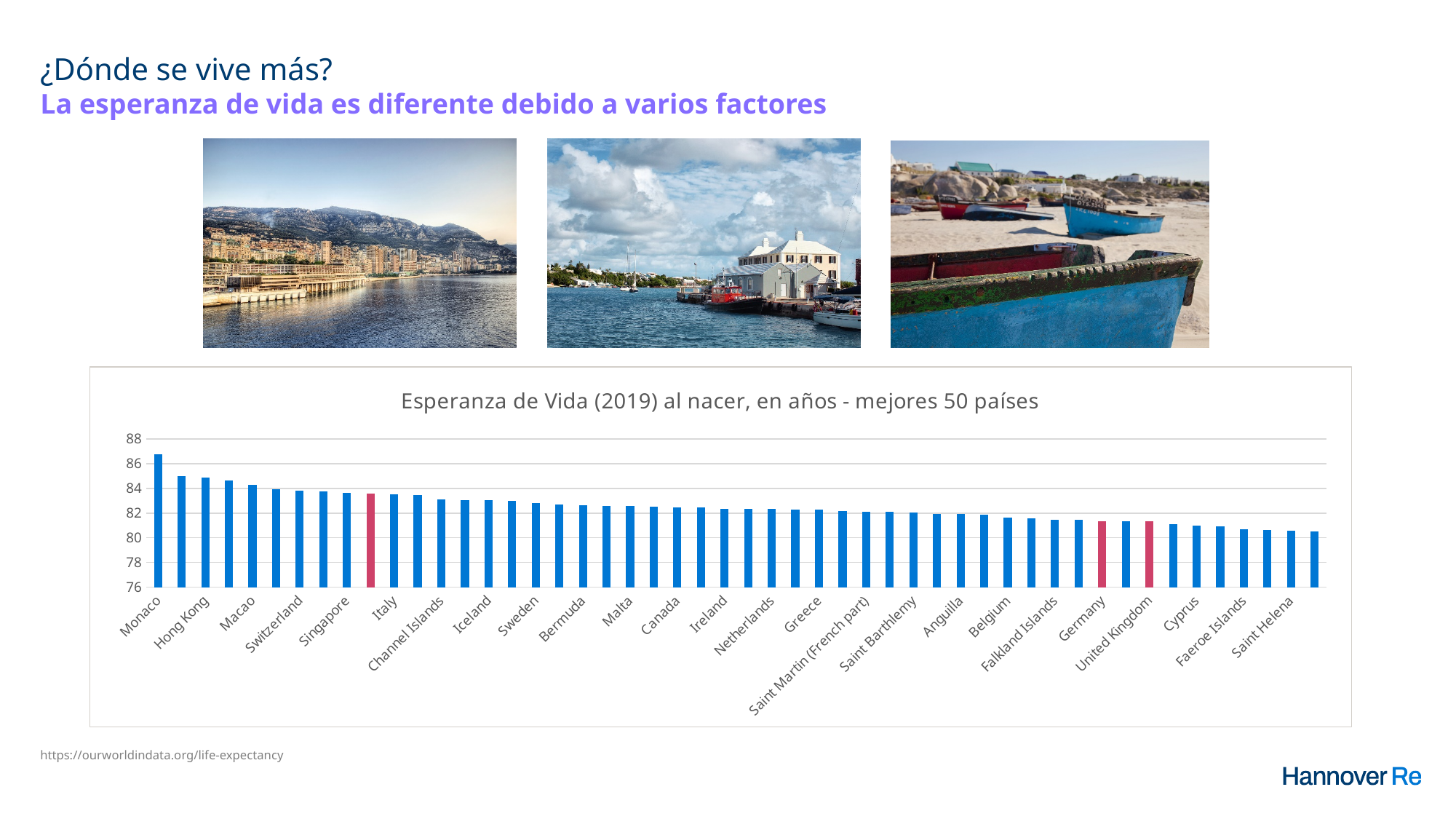
Which labelled countries are highlighted with red bars in the chart? Germany, United Kingdom What kind of chart is shown on the slide? bar chart Which country has the highest life expectancy in the chart? Monaco Is the value for Germany greater or less than 82? less Is the value for Italy greater or less than 82? greater Do the values rise or fall from left to right along the x axis? fall Is the value for Saint Helena greater or less than 82? less Which is larger, the value for Cyprus or the value for Sweden? Sweden What is the title of the chart? Esperanza de Vida (2019) al nacer, en años - mejores 50 países Which is larger, the value for Monaco or the value for Hong Kong? Monaco